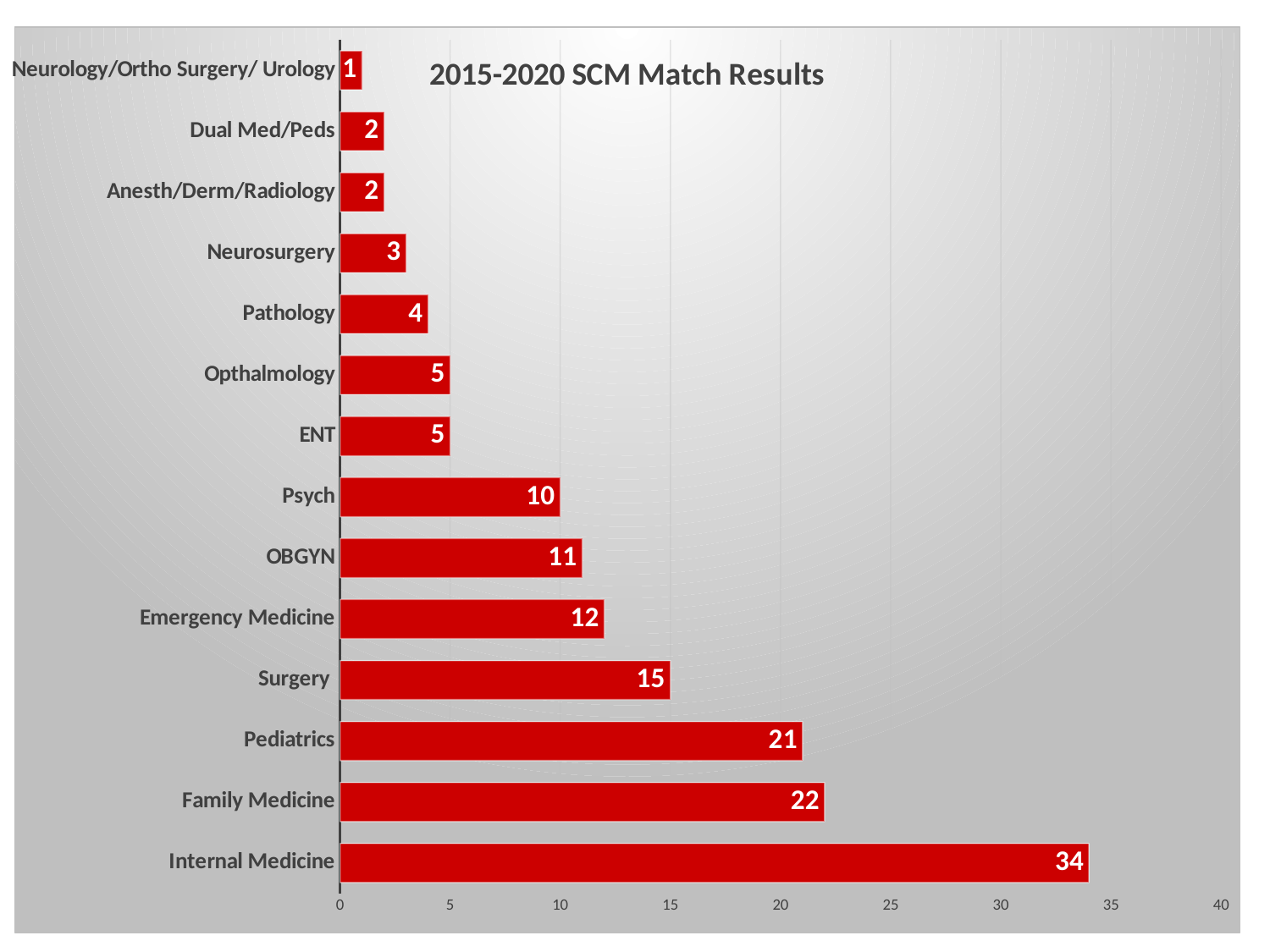
Which category has the highest value? Internal Medicine Which category has the lowest value? Neurology/Ortho Surgery/ Urology How many categories are shown in the chart? 14 What is the value for Internal Medicine? 34 What is the difference between Internal Medicine and Family Medicine? 12 Is the value for Pediatrics greater or less than 20? greater Which is larger, OBGYN or Psych? OBGYN What is the value for Pediatrics? 21 What is the title of the chart? 2015-2020 SCM Match Results What is the value for Emergency Medicine? 12 What is the difference between Surgery and Psych? 5 What kind of chart is this? bar chart